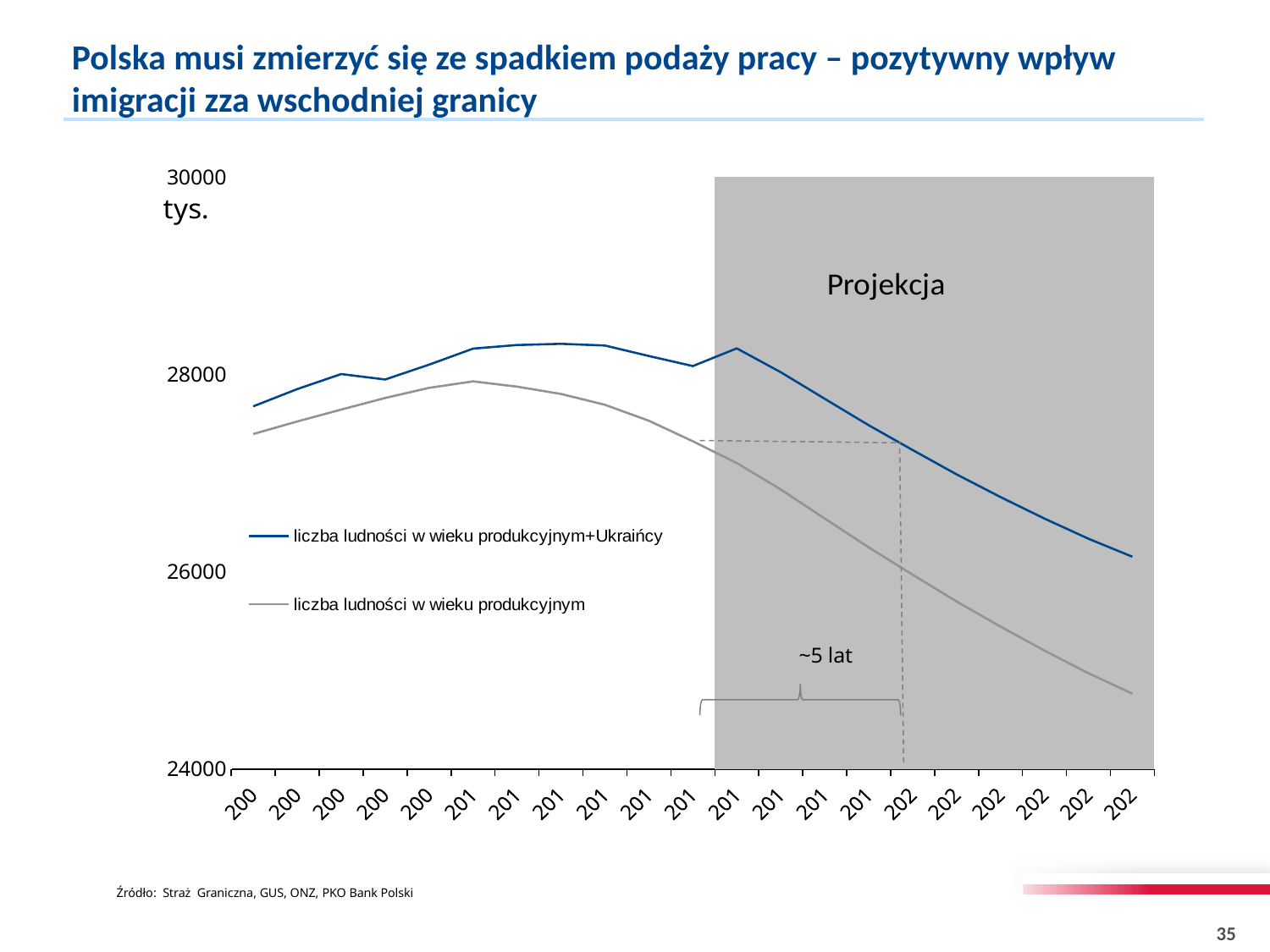
What is the highest value shown on the y axis of the chart? 30000 Is the highest value of the 'liczba ludności w wieku produkcyjnym+Ukraińcy' series greater or less than 28000? greater How many tick labels are there along the x axis of the chart? 21 At the right end of the chart, is the value for 'liczba ludności w wieku produkcyjnym' greater or less than 26000? less What label is written in the grey shaded area on the right of the chart? Projekcja In the shaded projection area, do the values of both series rise or fall along the x axis? fall Which series lies higher on the chart throughout, 'liczba ludności w wieku produkcyjnym+Ukraińcy' or 'liczba ludności w wieku produkcyjnym'? liczba ludności w wieku produkcyjnym+Ukraińcy At the right end of the chart, is the value for 'liczba ludności w wieku produkcyjnym+Ukraińcy' greater or less than 28000? less What kind of chart is shown on the slide? line chart How many series does the legend list? 2 What are the two series named in the legend? liczba ludności w wieku produkcyjnym+Ukraińcy; liczba ludności w wieku produkcyjnym